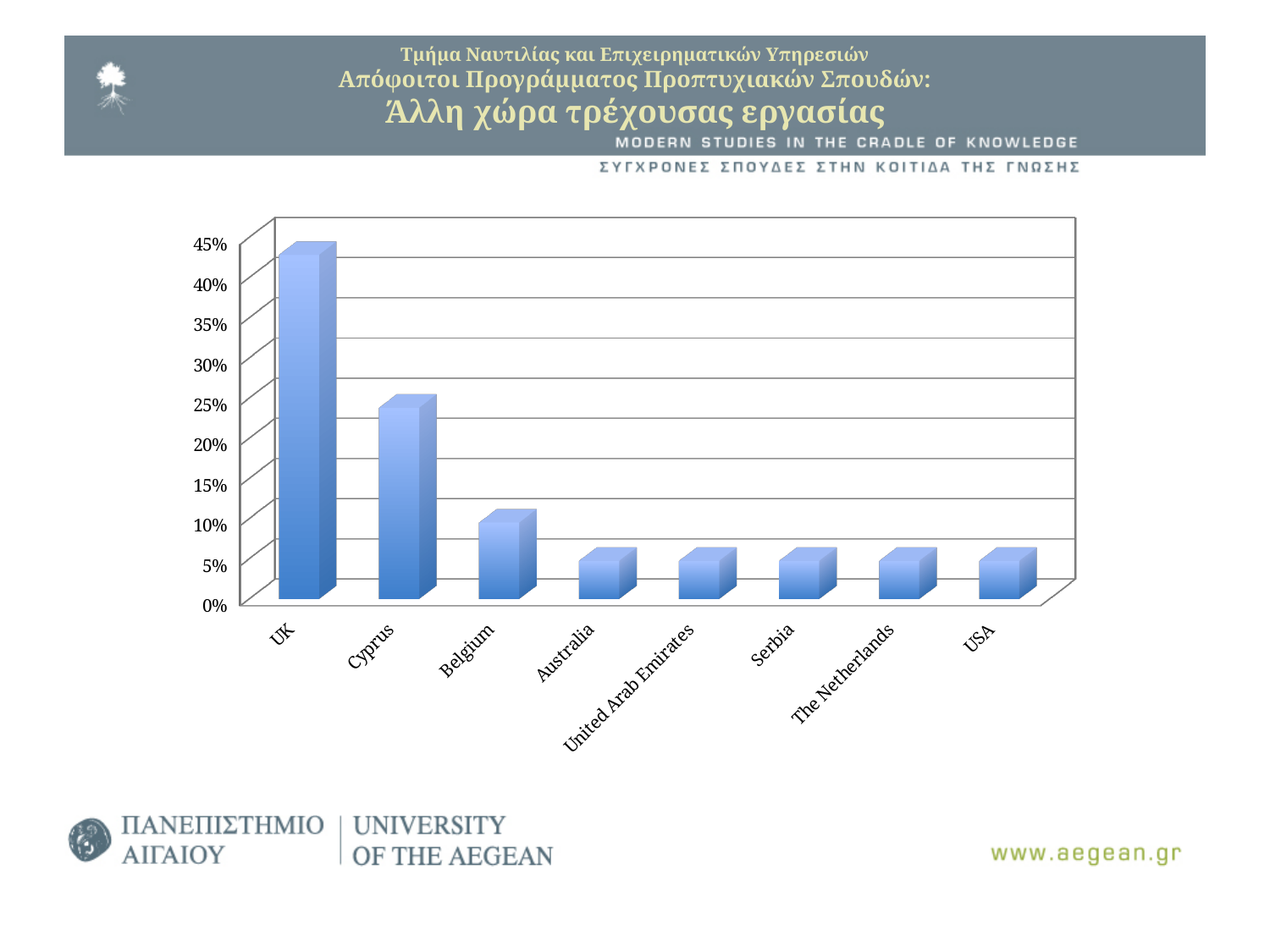
Is the value for Belgium greater or less than 5%? greater Do the values generally rise or fall moving from left to right along the x axis? fall Is the value for Cyprus greater or less than 30%? less Is the value for Belgium greater or less than 15%? less How many countries are shown on the x axis of the chart? 8 Which has a larger value, Belgium or Serbia? Belgium Which country has the highest value in the chart? UK Which has a larger value, UK or Cyprus? UK What kind of chart is shown on the slide? bar chart